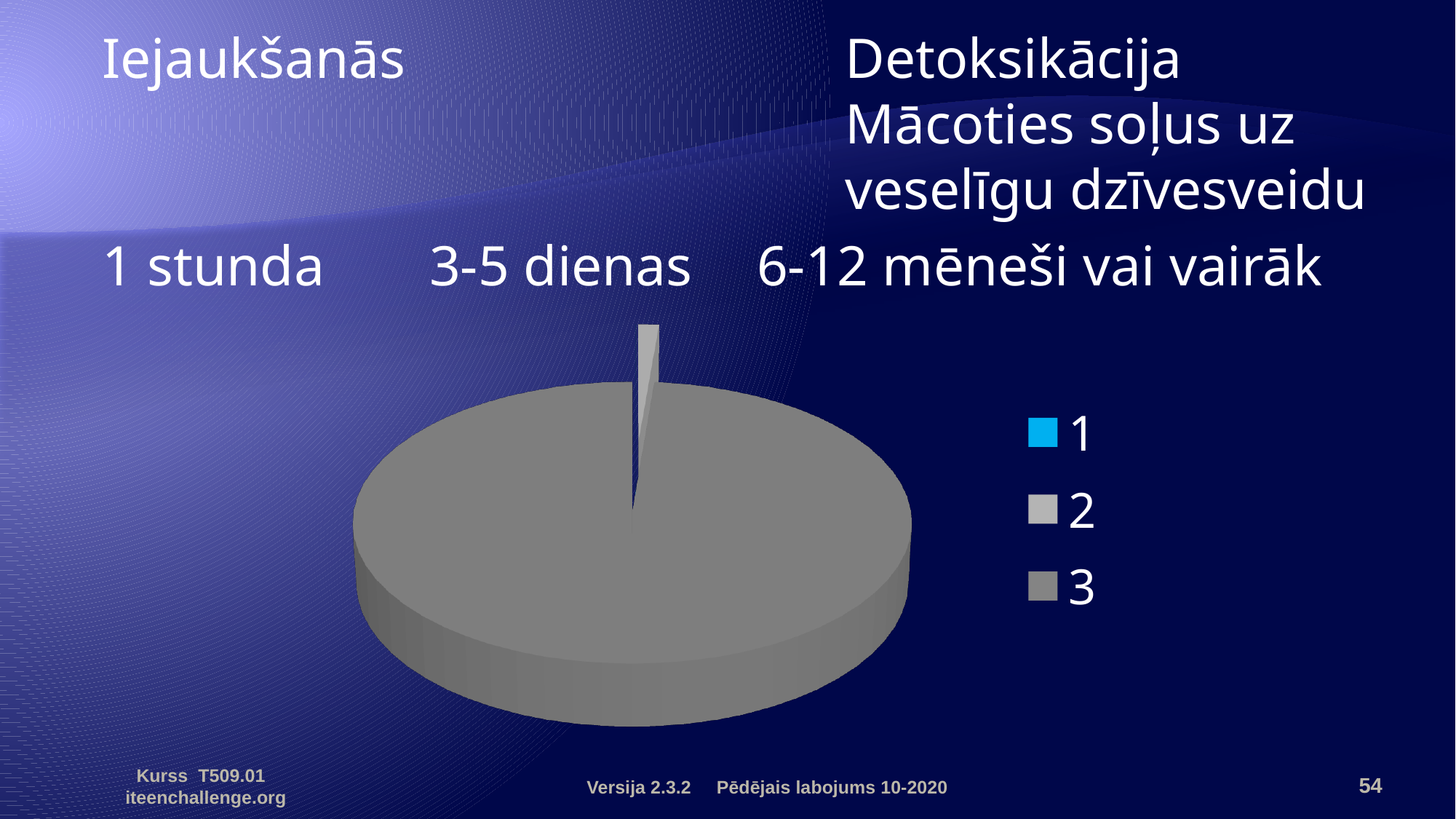
Which legend category has the largest slice of the pie chart? 3 What colour is used for category 3 in the pie chart legend? dark gray What colour is used for category 1 in the pie chart legend? blue What kind of chart is shown on the slide? pie chart How many categories are shown in the pie chart's legend? 3 Which slice is larger in the pie chart, category 2 or category 3? 3 How many entries does the legend of the pie chart list? 3